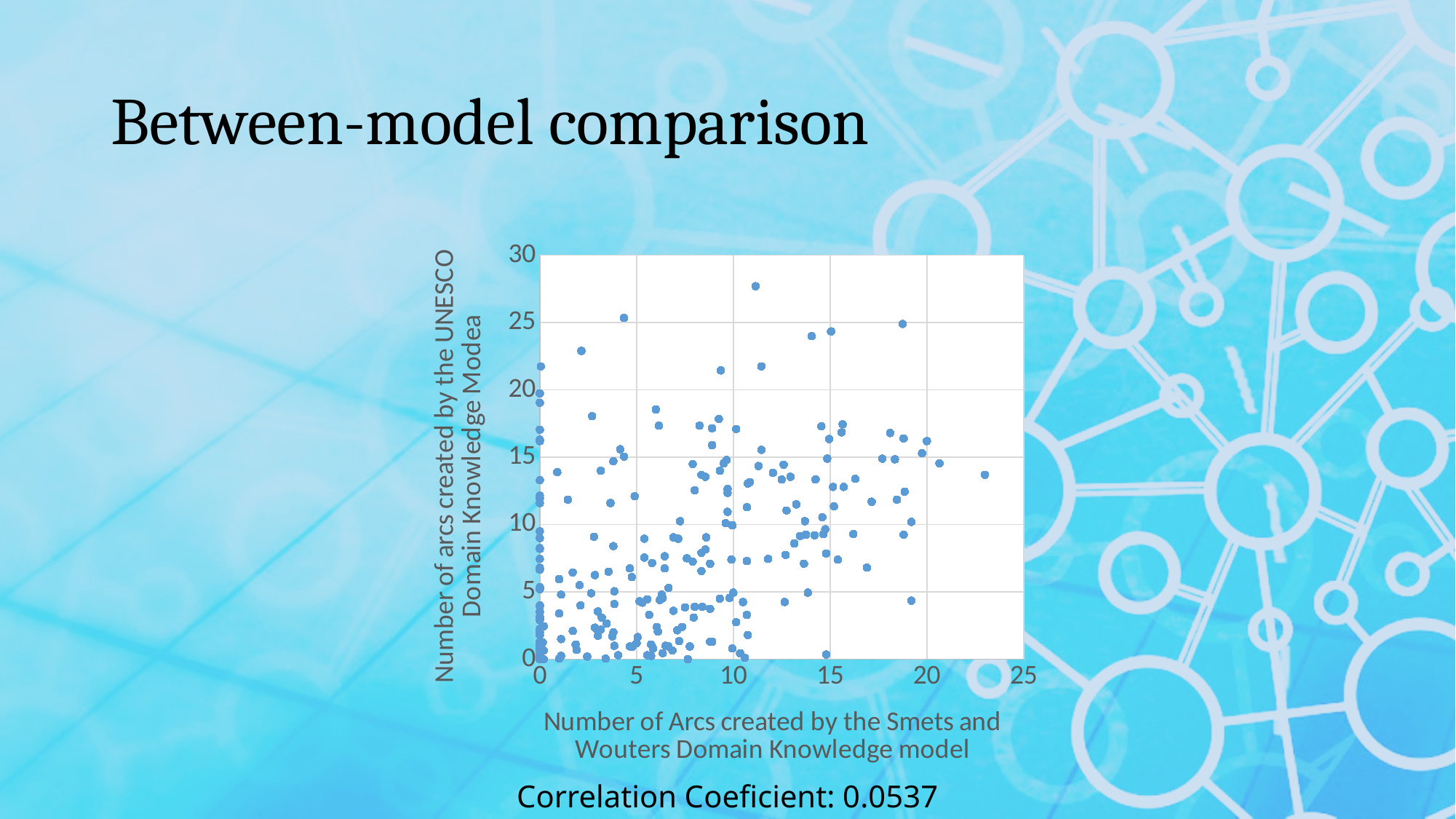
What is the maximum value shown on the y axis of the chart? 30 Does the chart show a strong rising trend in y values as x increases? no Is the largest x value plotted on the chart greater or less than 20? greater What is the label of the x axis of the chart? Number of Arcs created by the Smets and Wouters Domain Knowledge model Is the highest y value plotted on the chart greater or less than 25? greater What is the maximum value shown on the x axis of the chart? 25 What kind of chart is shown on the slide? scatter plot What is the interval between consecutive tick marks on the y axis? 5 What correlation coefficient is stated below the chart? 0.0537 What is the title of the slide containing the chart? Between-model comparison Is the highest y value plotted on the chart greater or less than 30? less